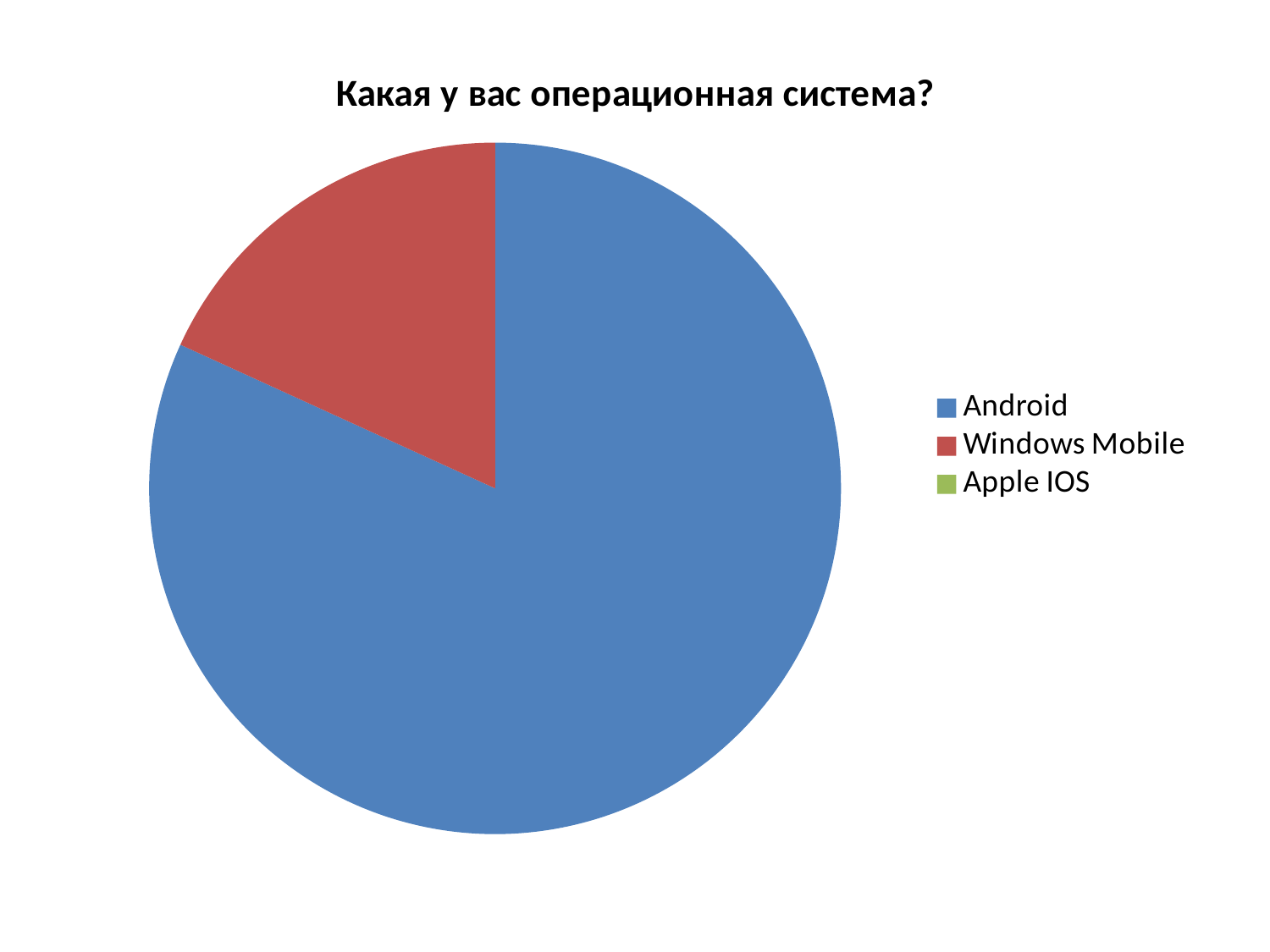
Which slice is larger, Windows Mobile or Apple IOS? Windows Mobile What kind of chart is shown on the slide? pie chart Which category has the largest slice of the pie? Android Does the Android slice take up more or less than half of the pie? more What is the title of the chart? Какая у вас операционная система? How many entries does the legend list? 3 Which slice is larger, Android or Windows Mobile? Android What colour is the Android slice? blue Which legend entry is shown in red? Windows Mobile